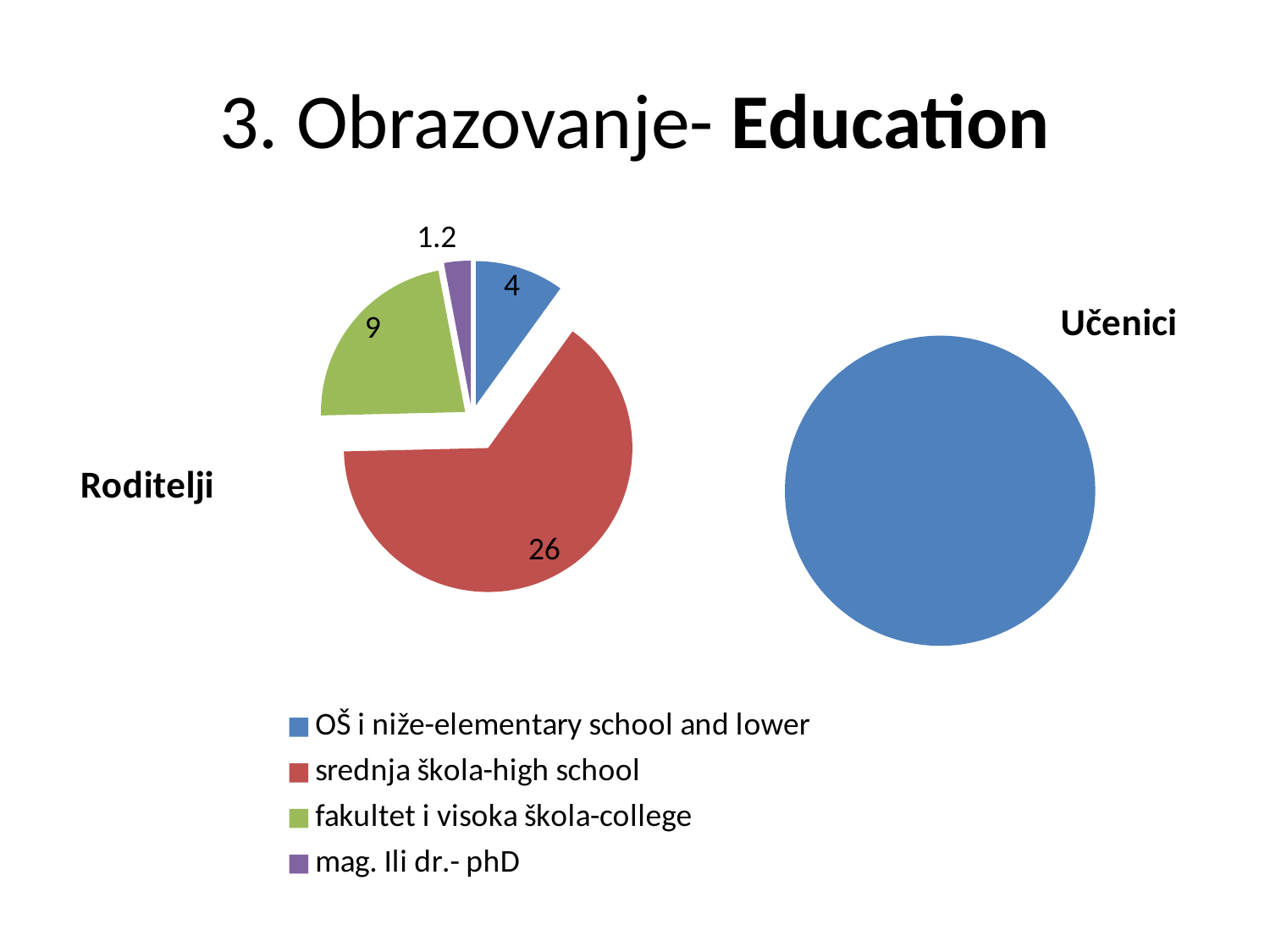
In the Roditelji pie chart, what is the value for mag. Ili dr.- phD? 1.2 How many slices does the Učenici pie chart on the right have? 1 Which legend category does the single slice of the Učenici pie chart correspond to, by colour? OŠ i niže-elementary school and lower What type of chart is the Roditelji chart on the left? pie chart In the Roditelji pie chart, which is larger: fakultet i visoka škola-college or OŠ i niže-elementary school and lower? fakultet i visoka škola-college How many categories does the legend list? 4 In the Roditelji pie chart, what is the value for OŠ i niže-elementary school and lower? 4 In the Roditelji pie chart, what is the difference between the values for srednja škola-high school and fakultet i visoka škola-college? 17 In the Roditelji pie chart, which category has the smallest slice? mag. Ili dr.- phD In the Roditelji pie chart, what is the value for fakultet i visoka škola-college? 9 In the Roditelji pie chart, which category has the largest slice? srednja škola-high school In the Roditelji pie chart, what is the value for srednja škola-high school? 26